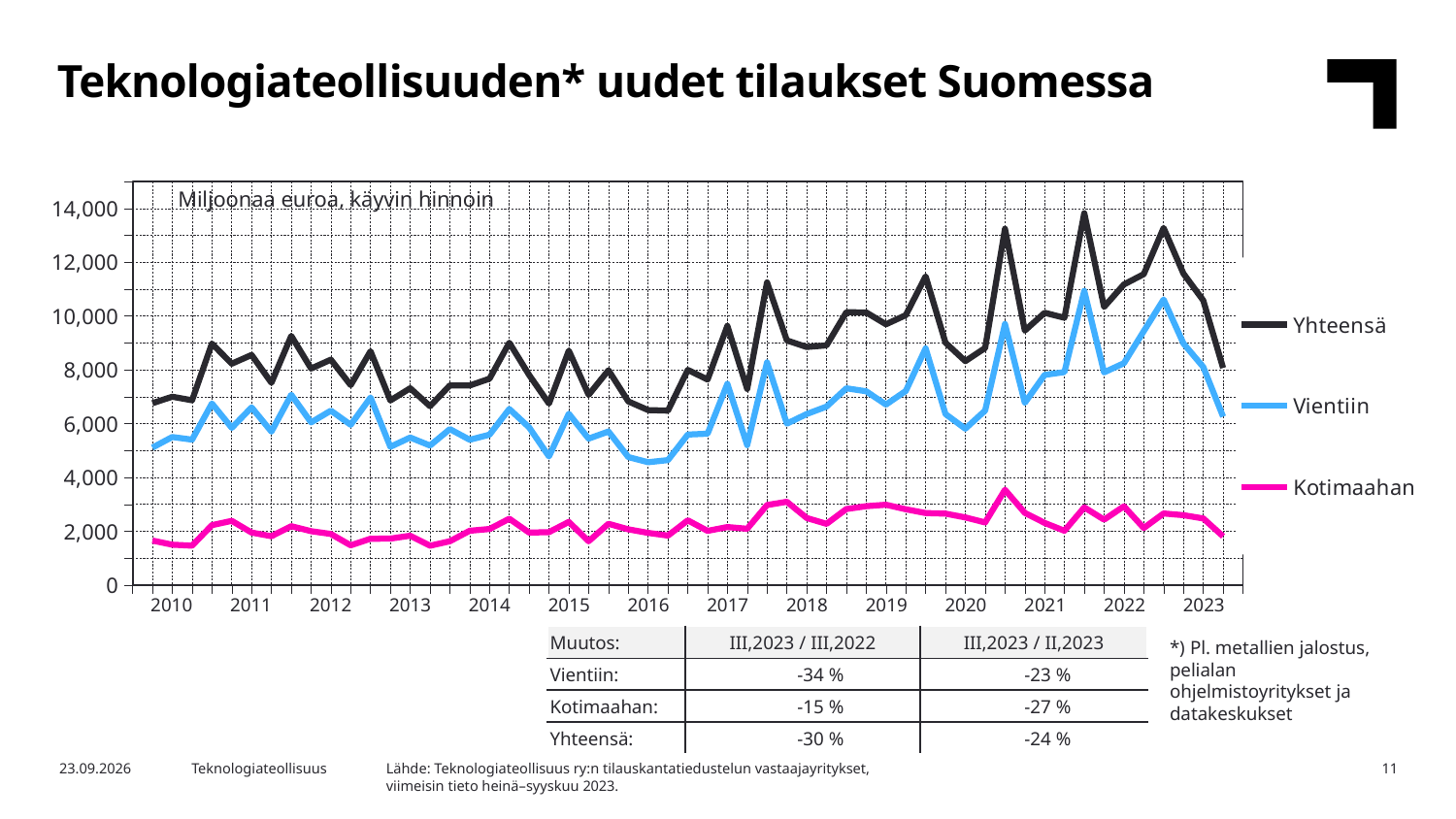
What are the three series named in the chart legend? Yhteensä, Vientiin, Kotimaahan Which series has the lowest values throughout the chart? Kotimaahan Which series has the highest values throughout the chart? Yhteensä What kind of chart is shown on the slide? line chart What unit label is printed inside the chart area? Miljoonaa euroa, käyvin hinnoin Is the value of the Yhteensä series at the start of 2010 greater or less than 8,000? less Is the highest value of the Kotimaahan series greater or less than 4,000? less Is the peak value of the Yhteensä series in 2021 greater or less than 12,000? greater Does the Kotimaahan series generally rise or fall from 2010 to 2018? rise Which series is larger in 2019, Vientiin or Kotimaahan? Vientiin How many year labels appear on the x axis of the chart? 14 How many series does the chart legend list? 3